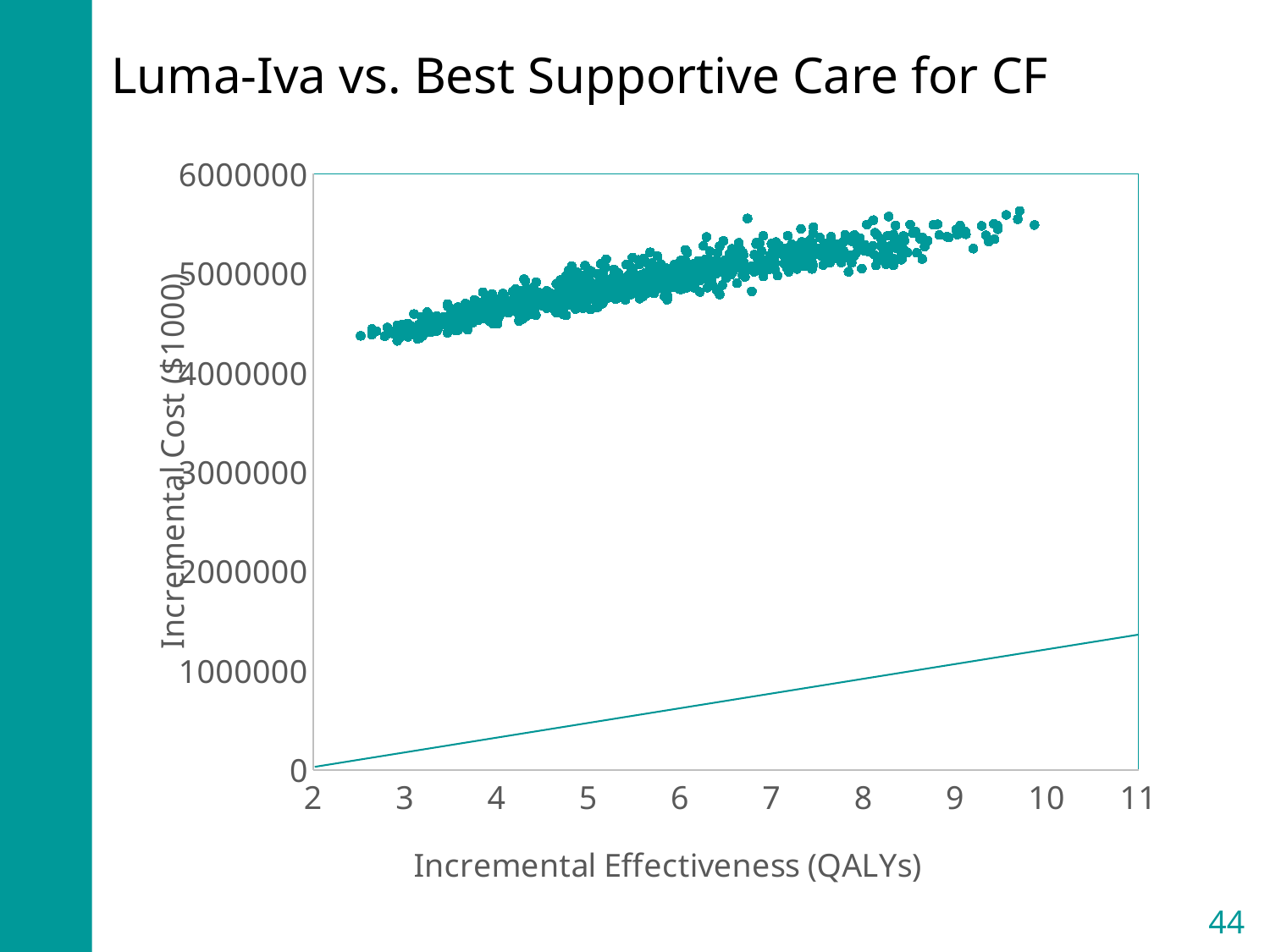
What is the title of the chart? Luma-Iva vs. Best Supportive Care for CF What is the maximum value shown on the y axis? 6000000 Are the incremental cost values of the scattered points greater or less than 4000000? greater Is the value of the straight line at an incremental effectiveness of 11 QALYs greater or less than 1000000? greater Is the value of the straight line at an incremental effectiveness of 11 QALYs greater or less than 2000000? less Which is higher at an incremental effectiveness of 6 QALYs: the scattered points or the straight line? The scattered points Does the straight line rise or fall from left to right? Rise Do the plotted points rise or fall as incremental effectiveness increases along the x axis? Rise What is the label of the x axis? Incremental Effectiveness (QALYs) What kind of chart is shown on the slide? Scatter plot